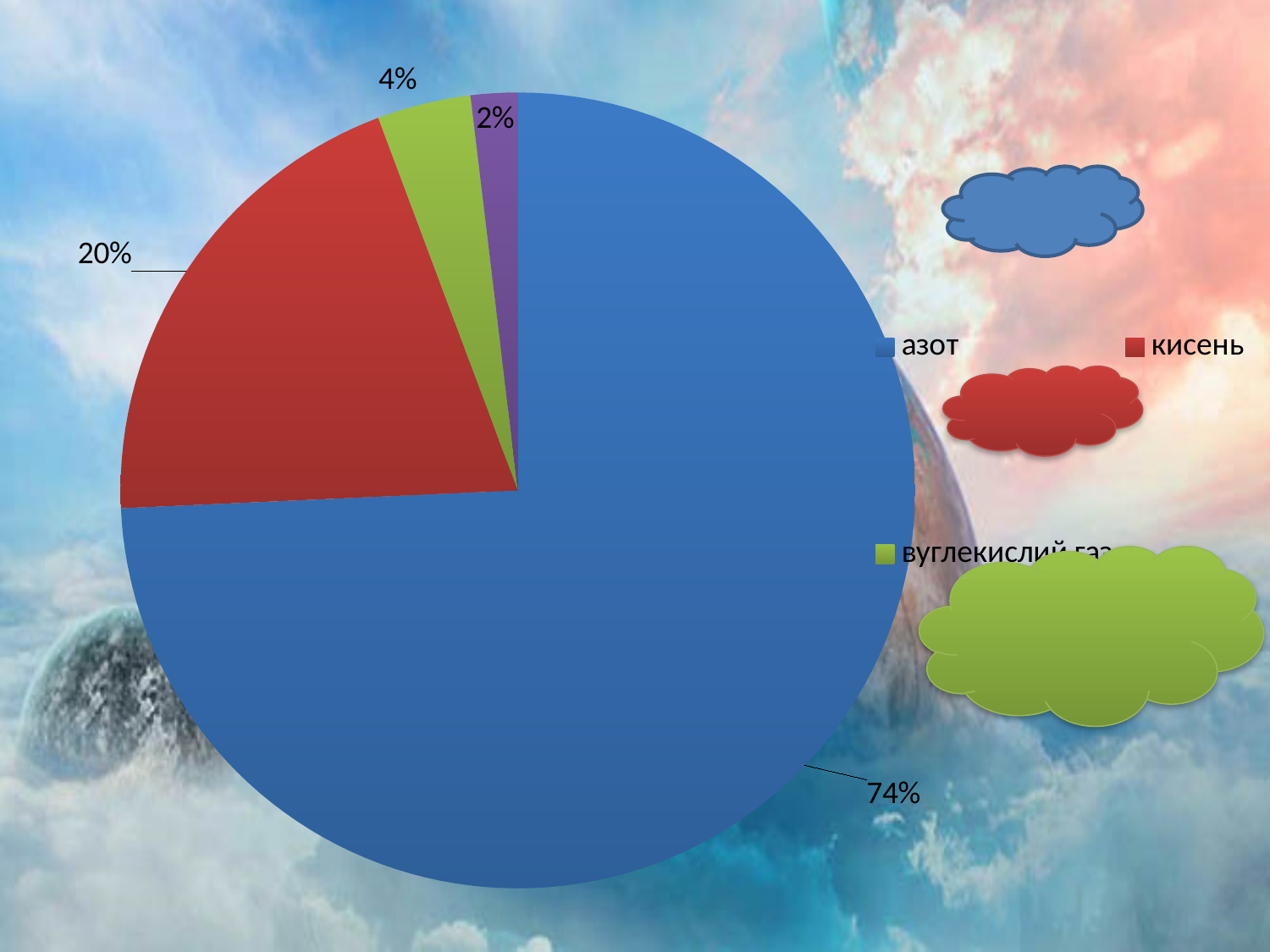
What kind of chart is shown on the slide? pie chart What percentage of the pie does вуглекислий газ account for? 4% What colour is the slice for азот? blue What percentage of the pie does азот account for? 74% What colour is the slice for кисень? red How many slices does the pie chart have? 4 What percentage of the pie does кисень account for? 20% Which is larger, the slice for кисень or the slice for вуглекислий газ? кисень What is the difference in percentage points between азот and кисень? 54 Which category has the largest slice of the pie? азот What is the smallest percentage labelled on the pie chart? 2%